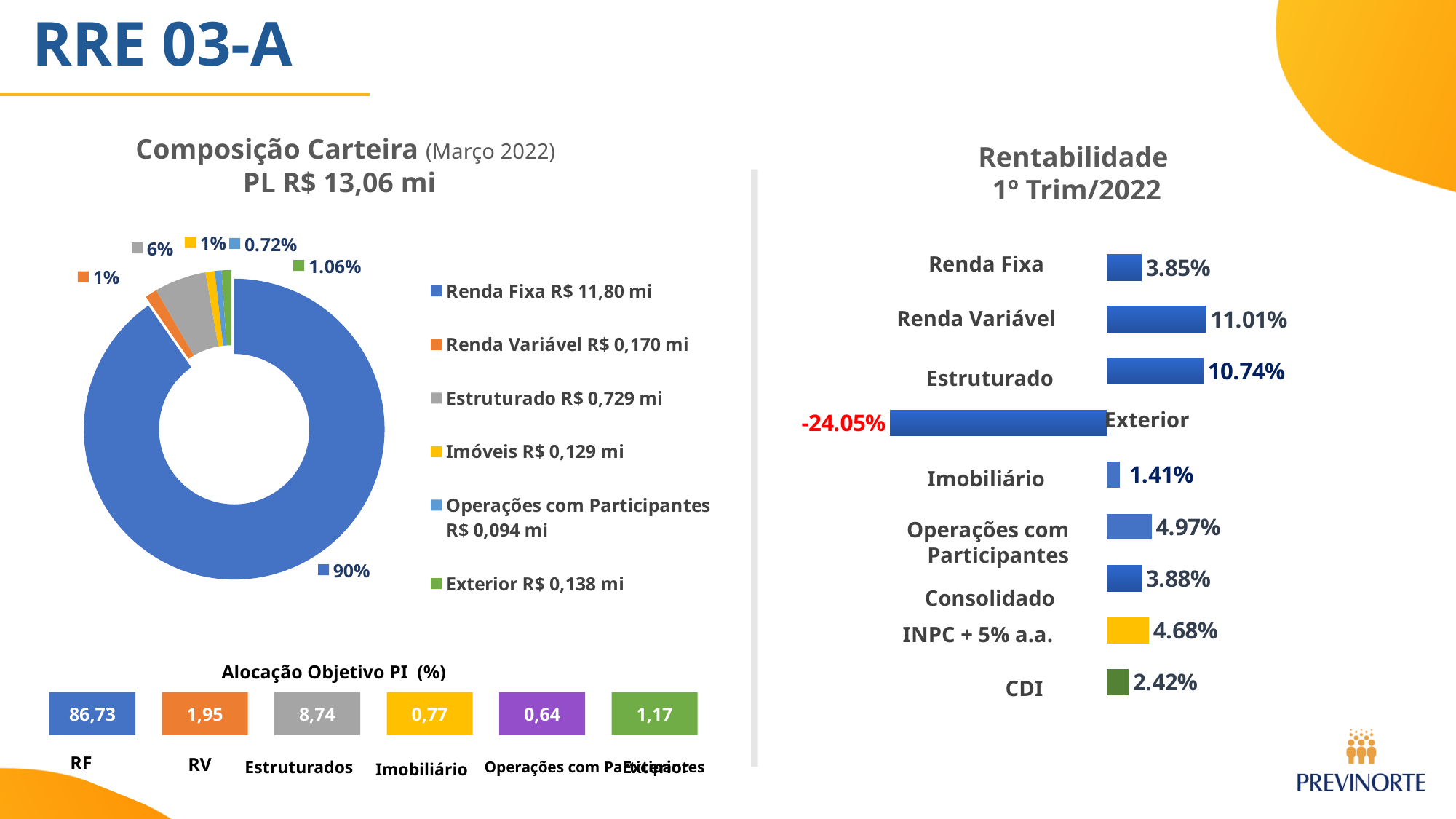
How many entries does the legend of the Composição Carteira chart list? 6 In the Rentabilidade 1º Trim/2022 chart, what is the difference between Renda Variável and Estruturado? 0.27% In the Rentabilidade 1º Trim/2022 chart, what is the value for Exterior? -24.05% In the Rentabilidade 1º Trim/2022 chart, which category has the lowest value? Exterior How many categories are shown in the Rentabilidade 1º Trim/2022 chart? 9 What kind of chart is the Composição Carteira chart? Donut (pie) chart In the Composição Carteira chart, what share of the portfolio is Renda Fixa? 90% In the Composição Carteira chart, what amount does the legend give for Estruturado? R$ 0,729 mi What kind of chart is the Rentabilidade 1º Trim/2022 chart? Bar chart In the Rentabilidade 1º Trim/2022 chart, which is larger: Consolidado or INPC + 5% a.a.? INPC + 5% a.a. In the Rentabilidade 1º Trim/2022 chart, which category has the highest value? Renda Variável In the Rentabilidade 1º Trim/2022 chart, what is the value for Renda Variável? 11.01%